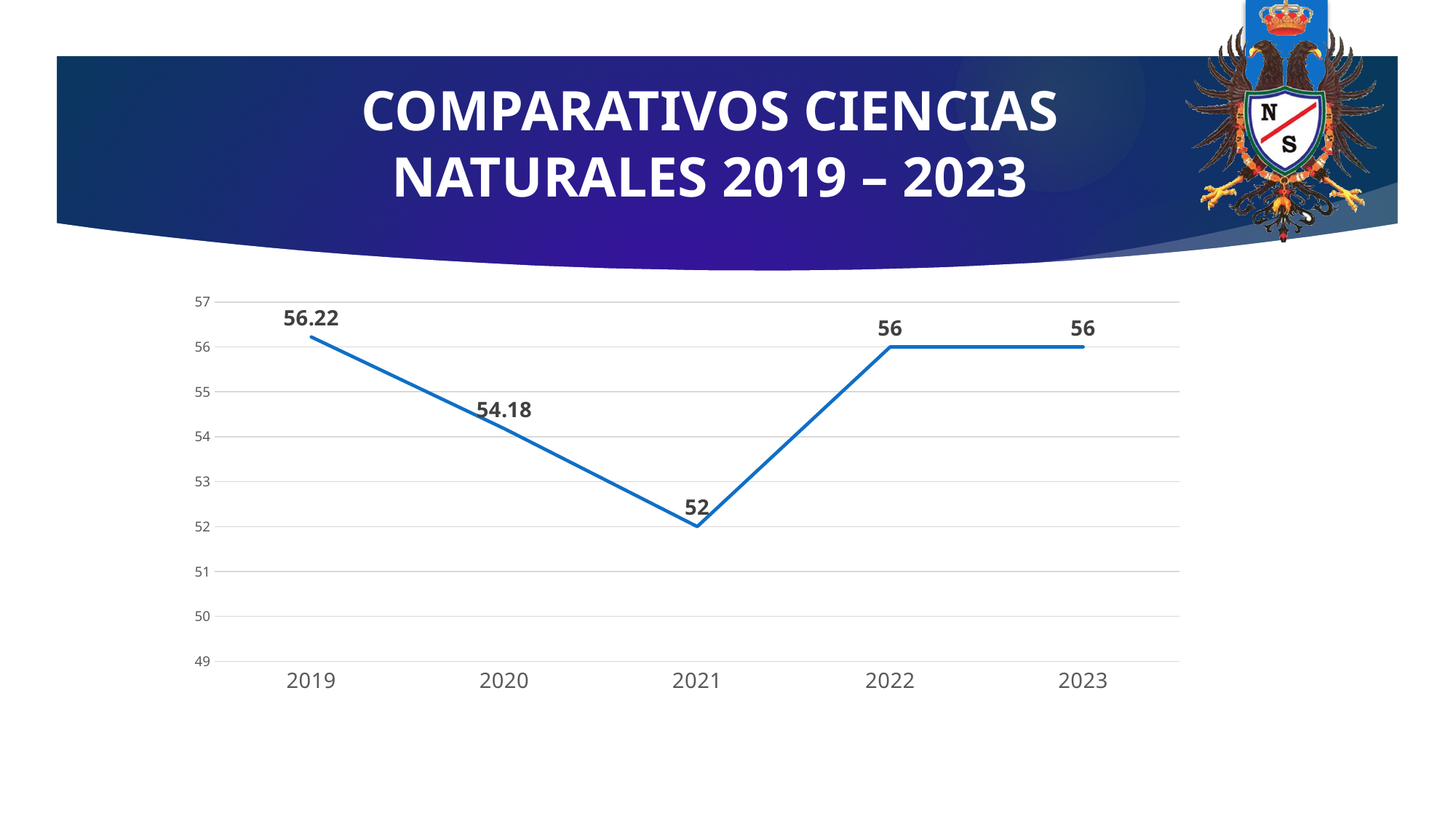
Which year has the lowest value? 2021 How many years are plotted on the chart? 5 What is the difference between the values for 2022 and 2021? 4 Which year has the highest value? 2019 What kind of chart is shown on the slide? line chart Which is larger, the value for 2020 or the value for 2021? 2020 What is the value for 2019? 56.22 What is the value for 2021? 52 What is the value for 2020? 54.18 Does the value rise or fall from 2019 to 2021? fall What is the value for 2022? 56 What is the difference between the values for 2019 and 2020? 2.04